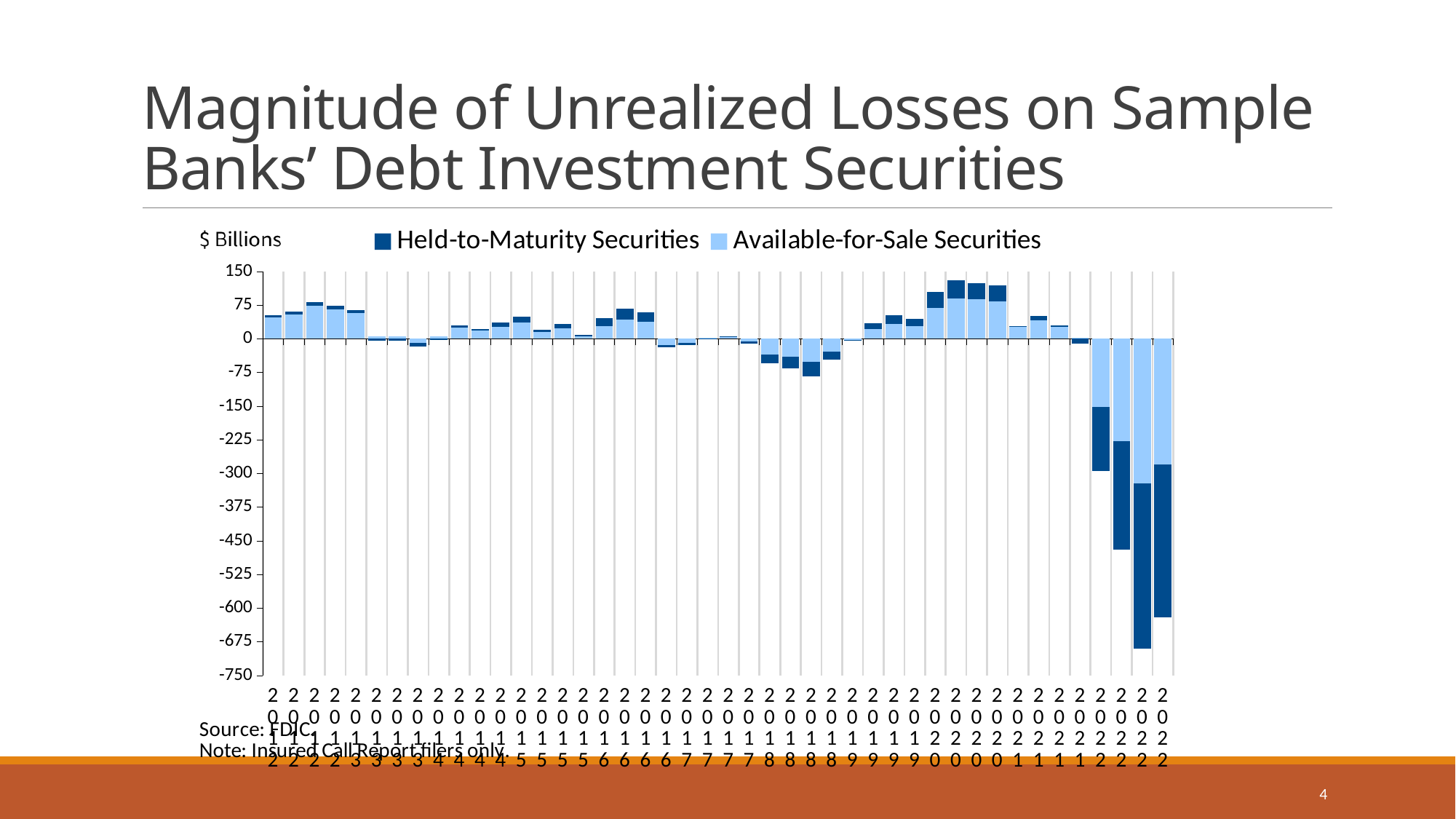
What is the first year shown on the x axis? 2012 Is the total of the tallest 2020 bar greater or less than 75? greater What kind of chart is shown on the slide? Stacked bar chart How many bars are plotted in the chart? 44 What is the last year shown on the x axis? 2022 What are the two series named in the legend? Held-to-Maturity Securities and Available-for-Sale Securities How many series does the legend list? 2 What unit is shown on the vertical axis label? $ Billions Is the total of the lowest 2022 bar greater or less than -600? less In which year do the bars reach their highest positive total? 2020 In which year do the bars reach their lowest (most negative) total? 2022 Do the bar totals rise or fall from 2021 to 2022? fall